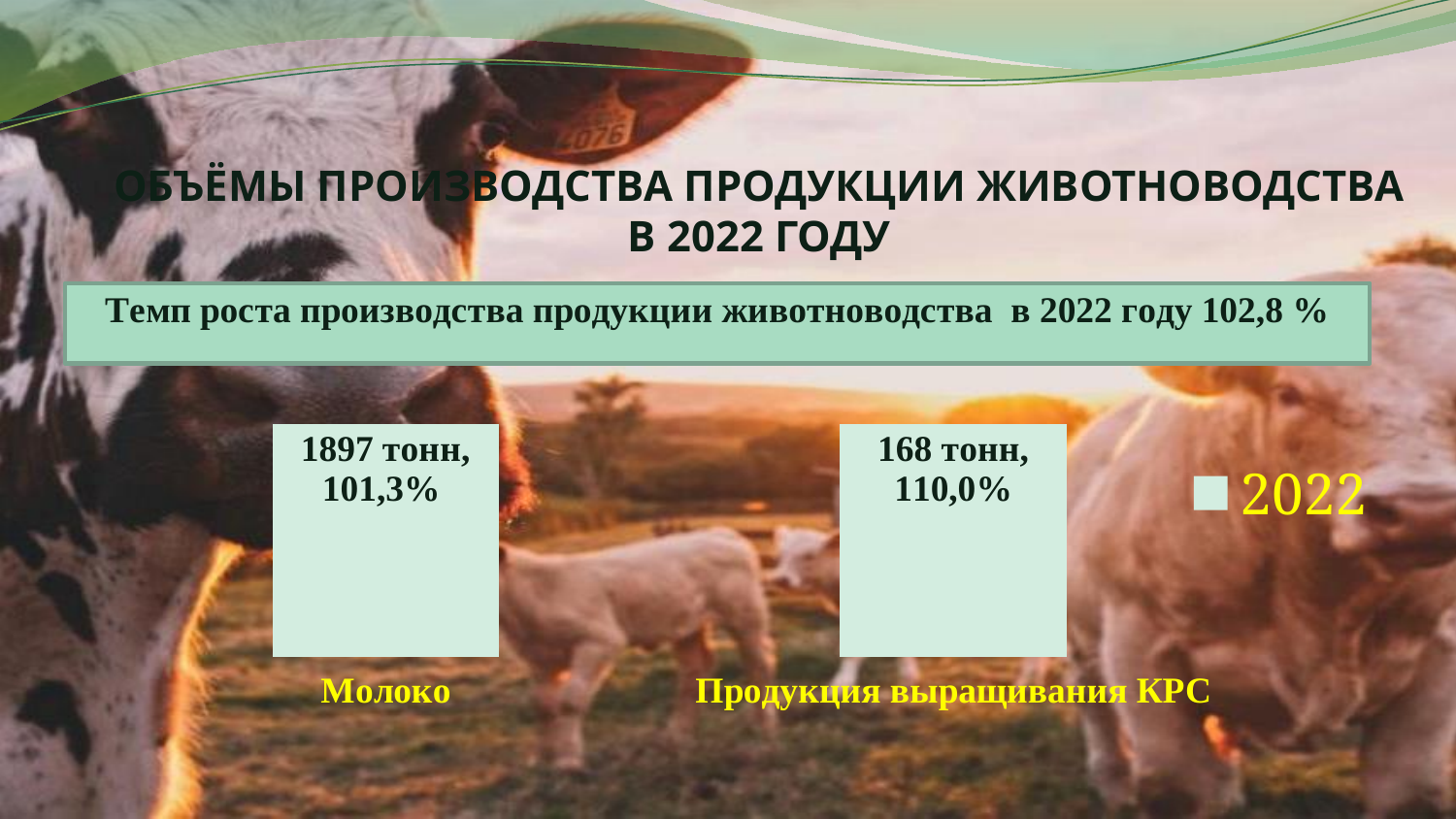
What is the difference in tonnes between the Молоко and Продукция выращивания КРС volumes? 1729 тонн What is the production volume shown for Продукция выращивания КРС? 168 тонн How many series does the legend list? 1 What growth rate is shown for Продукция выращивания КРС? 110,0% What is the production volume shown for Молоко? 1897 тонн What kind of chart is shown on the slide? Bar chart What overall growth rate of livestock production in 2022 is stated in the text box above the chart? 102,8 % Which category has the larger production volume in tonnes, Молоко or Продукция выращивания КРС? Молоко Which category has the higher growth rate, Молоко or Продукция выращивания КРС? Продукция выращивания КРС How many categories are shown in the chart? 2 What growth rate is shown for Молоко? 101,3% What year does the legend entry show? 2022